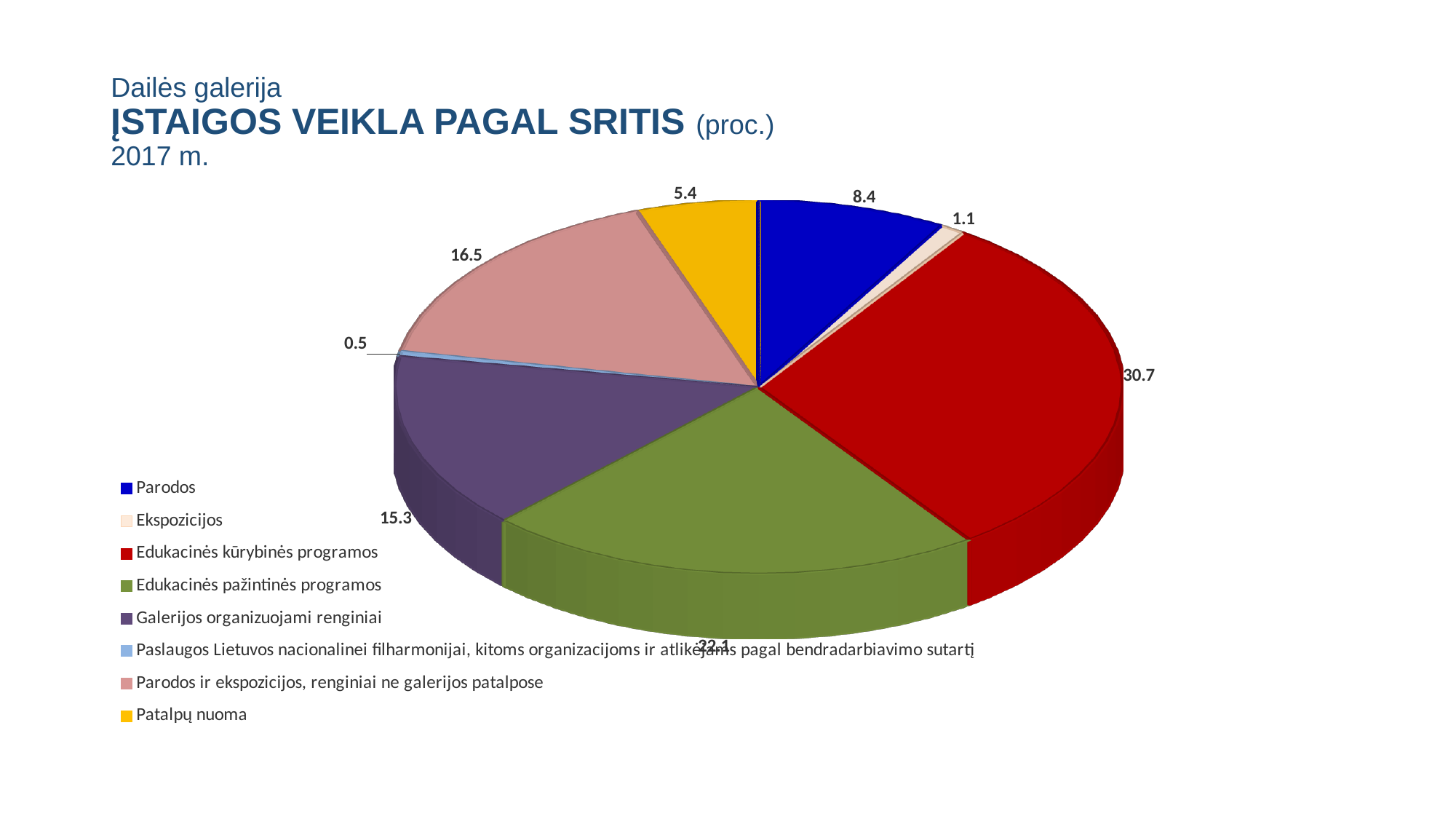
How many categories does the pie chart have? 8 What is the value for Parodos? 8.4 What is the value for Galerijos organizuojami renginiai? 15.3 Which is larger: Parodos ir ekspozicijos, renginiai ne galerijos patalpose or Galerijos organizuojami renginiai? Parodos ir ekspozicijos, renginiai ne galerijos patalpose What type of chart is shown on the slide? Pie chart What is the difference between the values for Parodos and Ekspozicijos? 7.3 What is the value for Patalpų nuoma? 5.4 What colour is the slice for Patalpų nuoma? Yellow What is the value for Edukacinės kūrybinės programos? 30.7 What is the difference between the values for Edukacinės kūrybinės programos and Edukacinės pažintinės programos? 8.6 Which category has the smallest share of the pie? Paslaugos Lietuvos nacionalinei filharmonijai, kitoms organizacijoms ir atlikėjams pagal bendradarbiavimo sutartį Which category has the largest share of the pie? Edukacinės kūrybinės programos